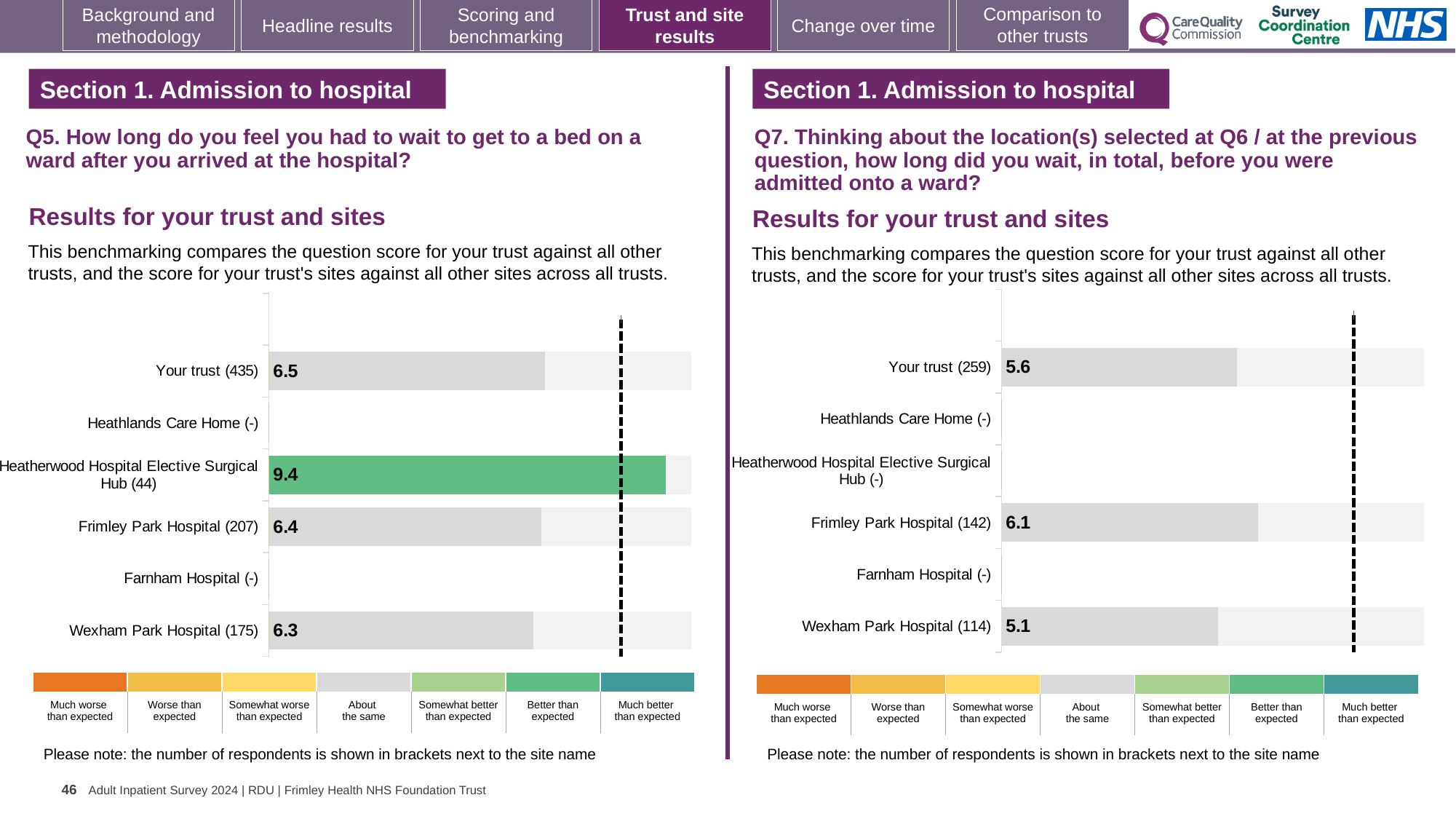
On the Q5 chart (left), what colour is the bar for Heatherwood Hospital Elective Surgical Hub (44)? Green On the Q7 chart (right), is the score for Frimley Park Hospital (142) larger or smaller than the score for Your trust (259)? Larger On the Q7 chart (right), what is the score for Frimley Park Hospital (142)? 6.1 On the Q5 chart (left), what is the difference between the scores for Heatherwood Hospital Elective Surgical Hub (44) and Wexham Park Hospital (175)? 3.1 What type of chart is used on the Q5 chart (left)? Bar chart On the Q7 chart (right), what is the score for Wexham Park Hospital (114)? 5.1 On the Q5 chart (left), which site has the highest score? Heatherwood Hospital Elective Surgical Hub (44) On the Q5 chart (left), how many site/trust categories are listed on the vertical axis? 6 On the Q7 chart (right), what is the difference between the scores for Frimley Park Hospital (142) and Wexham Park Hospital (114)? 1.0 On the Q7 chart (right), which of the sites with a plotted score has the lowest score? Wexham Park Hospital (114) On the Q5 chart (left), what is the score for Your trust (435)? 6.5 On the Q5 chart (left), what is the score for Heatherwood Hospital Elective Surgical Hub (44)? 9.4